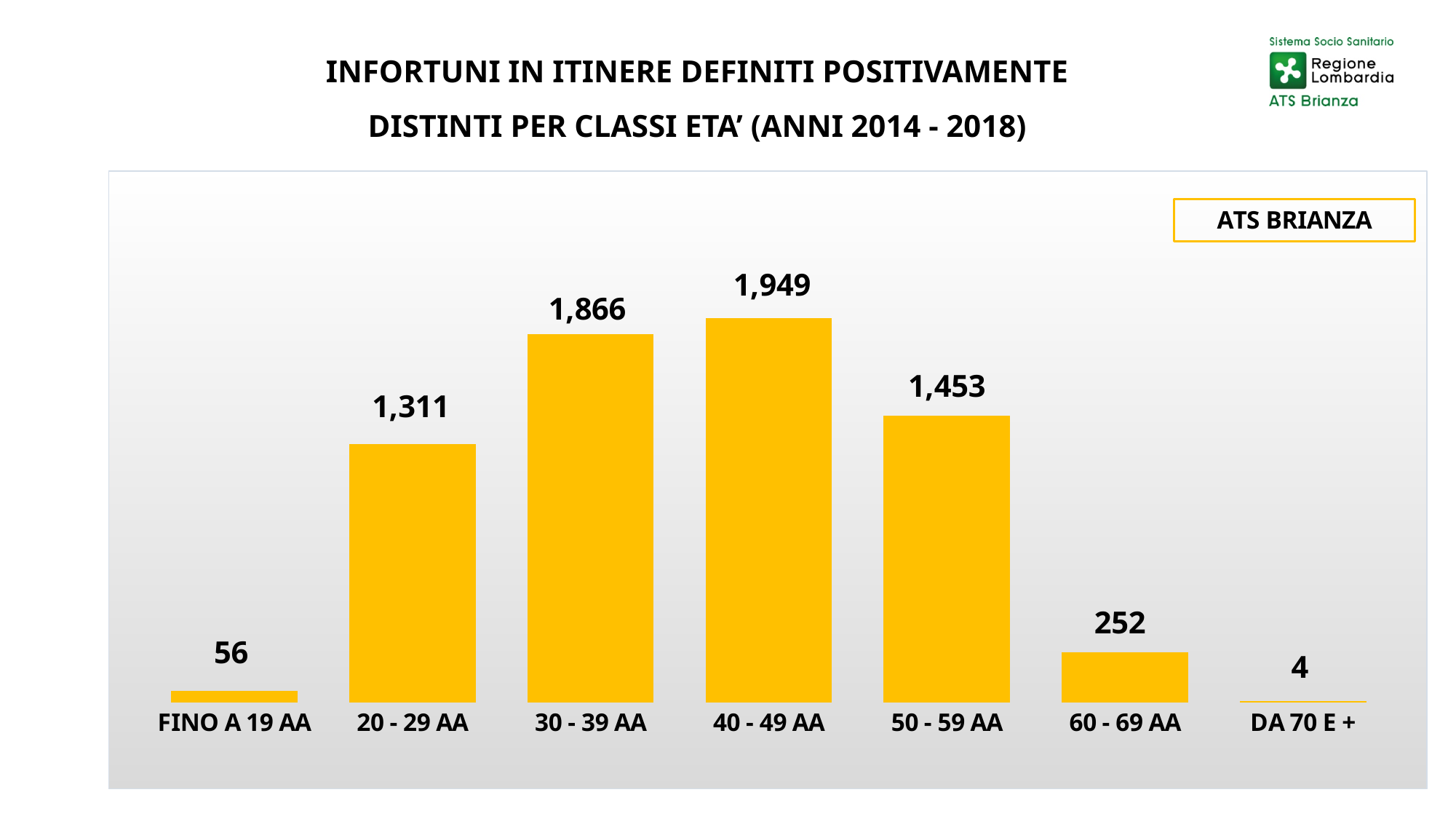
What label appears in the box at the top right of the chart area? ATS BRIANZA Which age class has the lowest value? DA 70 E + Which age class has the highest value? 40 - 49 AA What kind of chart is shown on the slide? Bar chart What is the value for the FINO A 19 AA age class? 56 How many age classes are shown in the chart? 7 What is the value for the 60 - 69 AA age class? 252 Do the values rise or fall from 40 - 49 AA to DA 70 E + along the x axis? Fall What is the difference between the values for 50 - 59 AA and 20 - 29 AA? 142 What is the value for the 40 - 49 AA age class? 1,949 What is the difference between the values for 40 - 49 AA and 30 - 39 AA? 83 Which is larger, the value for 20 - 29 AA or the value for 50 - 59 AA? 50 - 59 AA